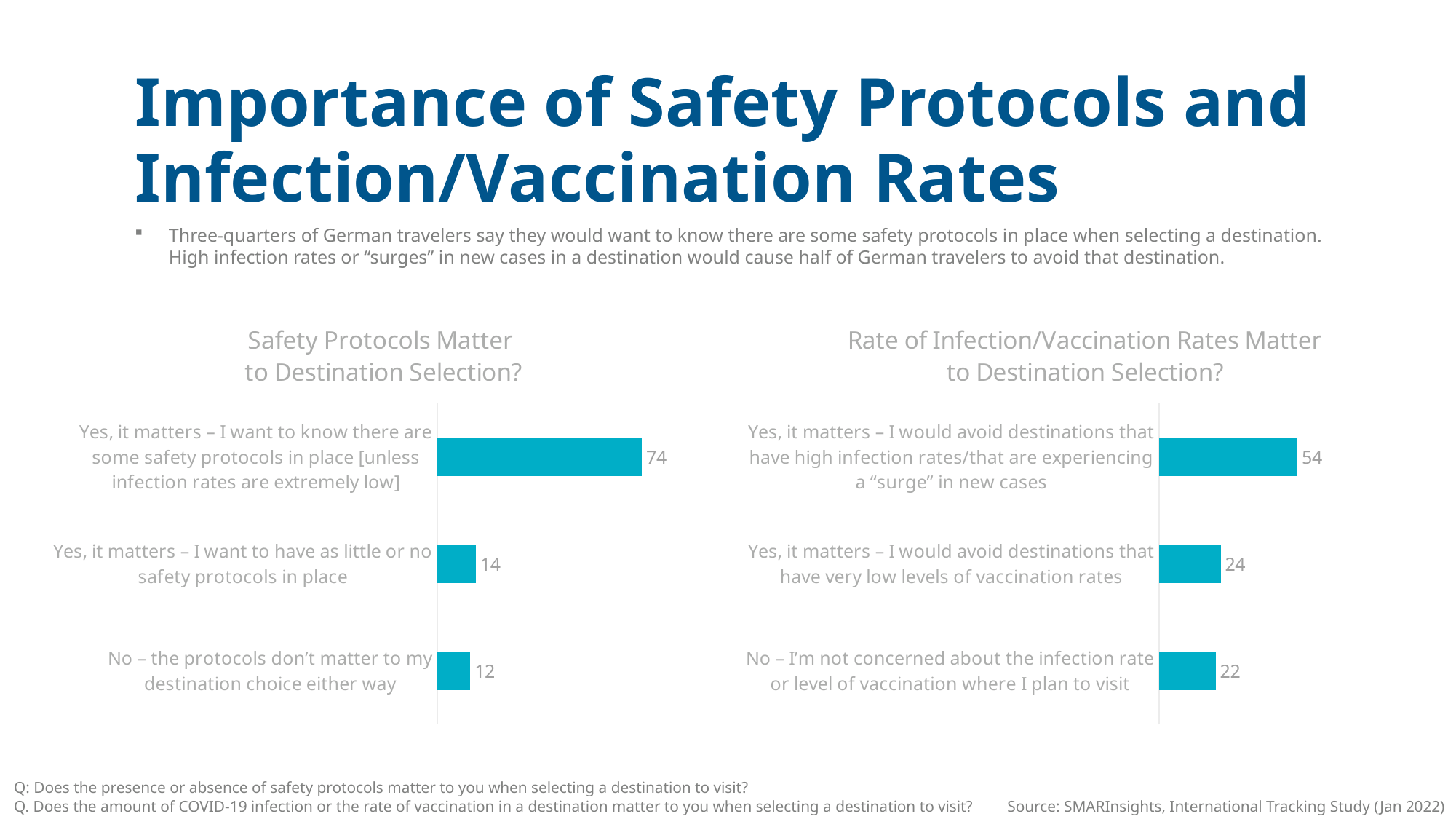
What type of chart is the 'Rate of Infection/Vaccination Rates Matter to Destination Selection?' chart? Bar chart How many charts are shown on the slide? 2 Which is larger: the value for 'No' in the 'Safety Protocols Matter' chart or the value for 'No' in the 'Rate of Infection/Vaccination Rates Matter' chart? The 'No' value in the Rate of Infection/Vaccination Rates Matter chart (22) In the 'Safety Protocols Matter to Destination Selection?' chart, which category has the lowest value? No – the protocols don't matter to my destination choice either way In the 'Rate of Infection/Vaccination Rates Matter to Destination Selection?' chart, what is the value for 'Yes, it matters – I would avoid destinations that have very low levels of vaccination rates'? 24 In the 'Rate of Infection/Vaccination Rates Matter to Destination Selection?' chart, which category has the highest value? Yes, it matters – I would avoid destinations that have high infection rates/that are experiencing a "surge" in new cases What is the title of the chart on the left side of the slide? Safety Protocols Matter to Destination Selection? In the 'Rate of Infection/Vaccination Rates Matter to Destination Selection?' chart, what is the difference between the highest value and the lowest value? 32 How many categories are shown in the 'Safety Protocols Matter to Destination Selection?' chart? 3 In the 'Safety Protocols Matter to Destination Selection?' chart, what is the difference between the value for wanting to know there are some safety protocols in place (74) and wanting as little or no safety protocols (14)? 60 In the 'Safety Protocols Matter to Destination Selection?' chart, what is the value for 'Yes, it matters – I want to know there are some safety protocols in place'? 74 In the 'Safety Protocols Matter to Destination Selection?' chart, what is the value for 'No – the protocols don't matter to my destination choice either way'? 12